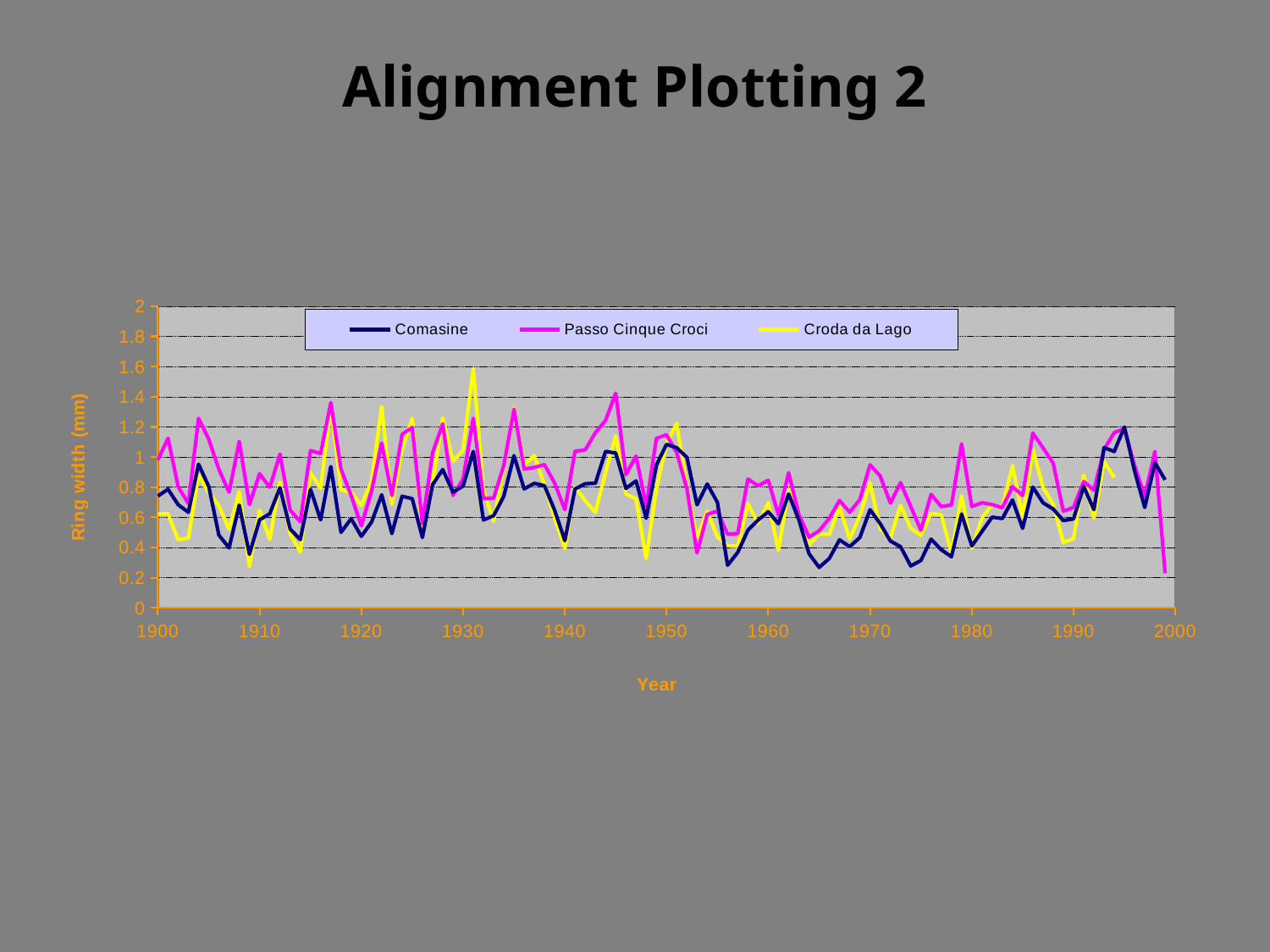
Is the highest value reached by Comasine greater or less than 1? greater Does the Passo Cinque Croci line rise or fall over its final step at the right end of the chart? fall How many series does the legend list? 3 Is the highest value reached by Croda da Lago greater or less than 1.4? greater Which series is drawn in yellow? Croda da Lago Is the last plotted value of Passo Cinque Croci, at the right end of the chart, greater or less than 0.4? less Which series reaches the highest ring width anywhere on the chart? Croda da Lago What kind of chart is shown on the slide? line chart How many year labels are shown along the x axis? 11 What is the title of the y axis? Ring width (mm)